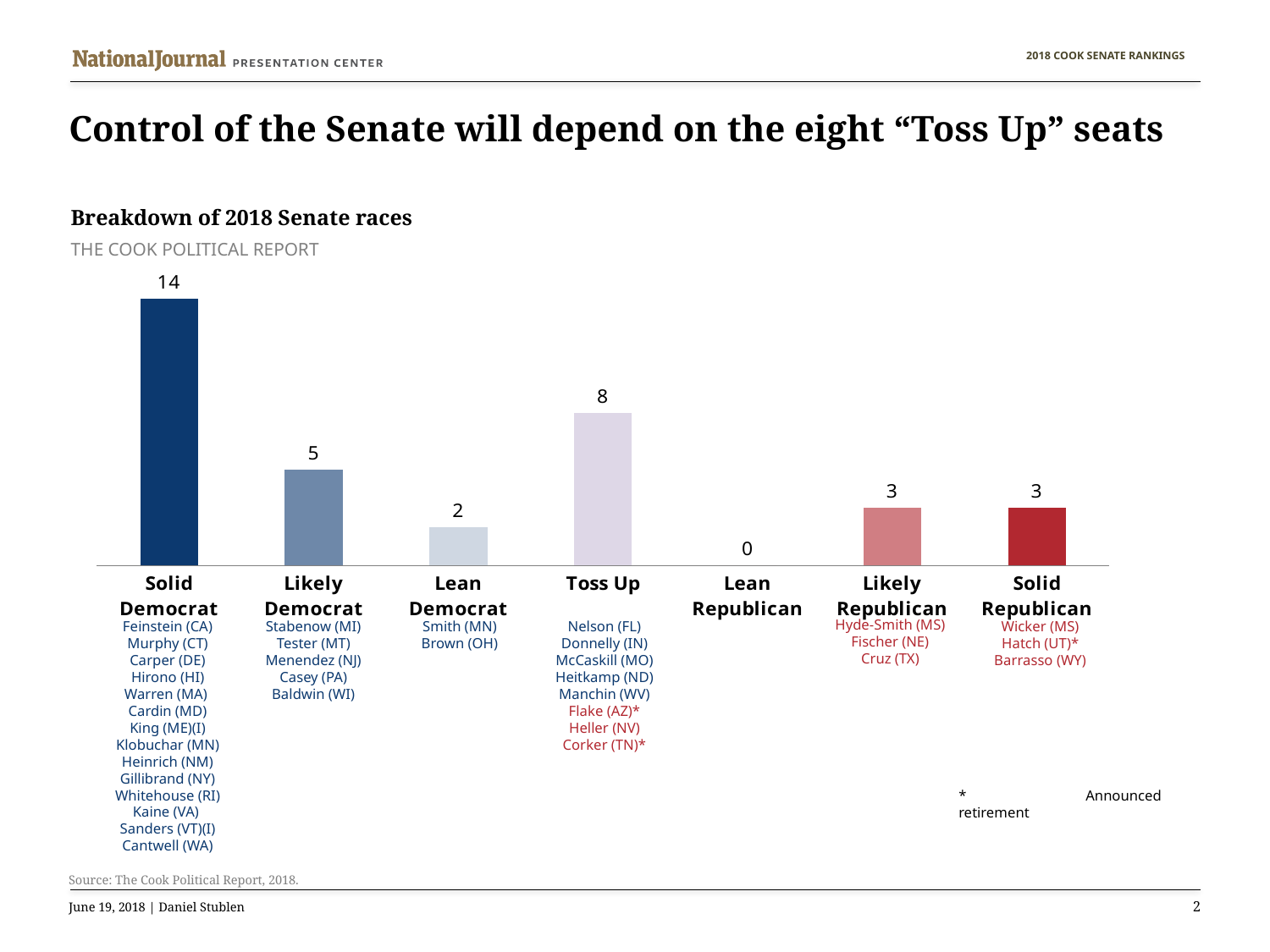
What is the difference between the Likely Democrat and Lean Democrat values? 3 How many Senate races are rated Solid Democrat? 14 What is the title of the chart? Breakdown of 2018 Senate races What is the value for Solid Republican? 3 Which category has the lowest number of races? Lean Republican What is the difference between the Solid Democrat and Toss Up values? 6 How many races are rated Lean Republican? 0 Which category has the highest number of races? Solid Democrat What is the value for the Toss Up category? 8 What kind of chart is this? Bar chart Which is larger, Likely Democrat or Likely Republican? Likely Democrat How many categories are shown on the x axis? 7